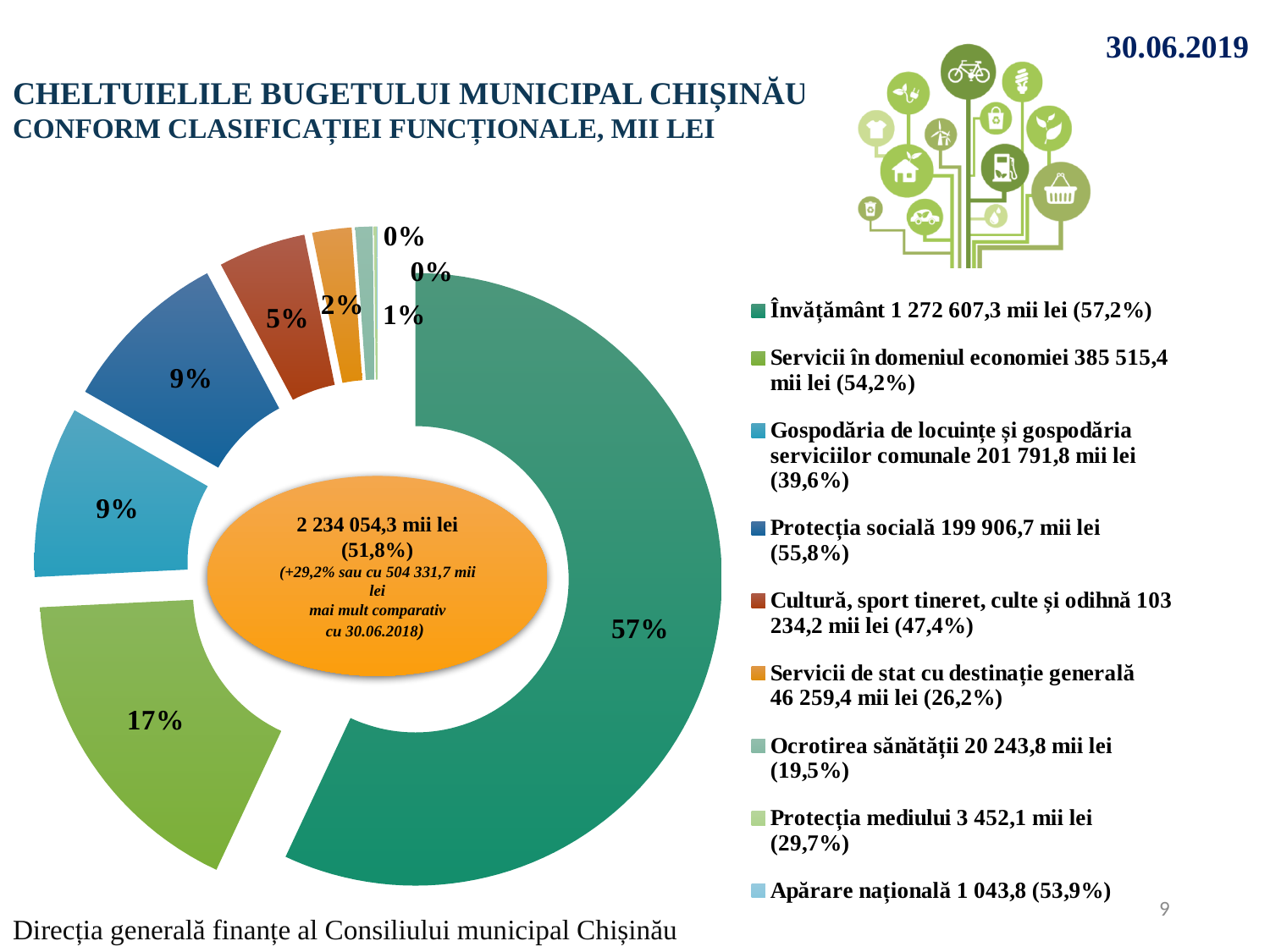
What share of the pie chart does Cultură, sport tineret, culte și odihnă represent? 5% What share of the pie chart does Servicii în domeniul economiei represent? 17% What kind of chart is shown on the slide? doughnut chart What share of the pie chart does Învățământ represent? 57% According to the legend, what is the value for Protecția socială? 199 906,7 mii lei What total amount is shown in the centre of the pie chart? 2 234 054,3 mii lei Which slice is larger: Protecția socială or Cultură, sport tineret, culte și odihnă? Protecția socială How many categories does the legend of the pie chart list? 9 Which category has the largest slice of the pie chart? Învățământ What is the difference in percentage points between the Învățământ slice and the Servicii în domeniul economiei slice? 40 percentage points